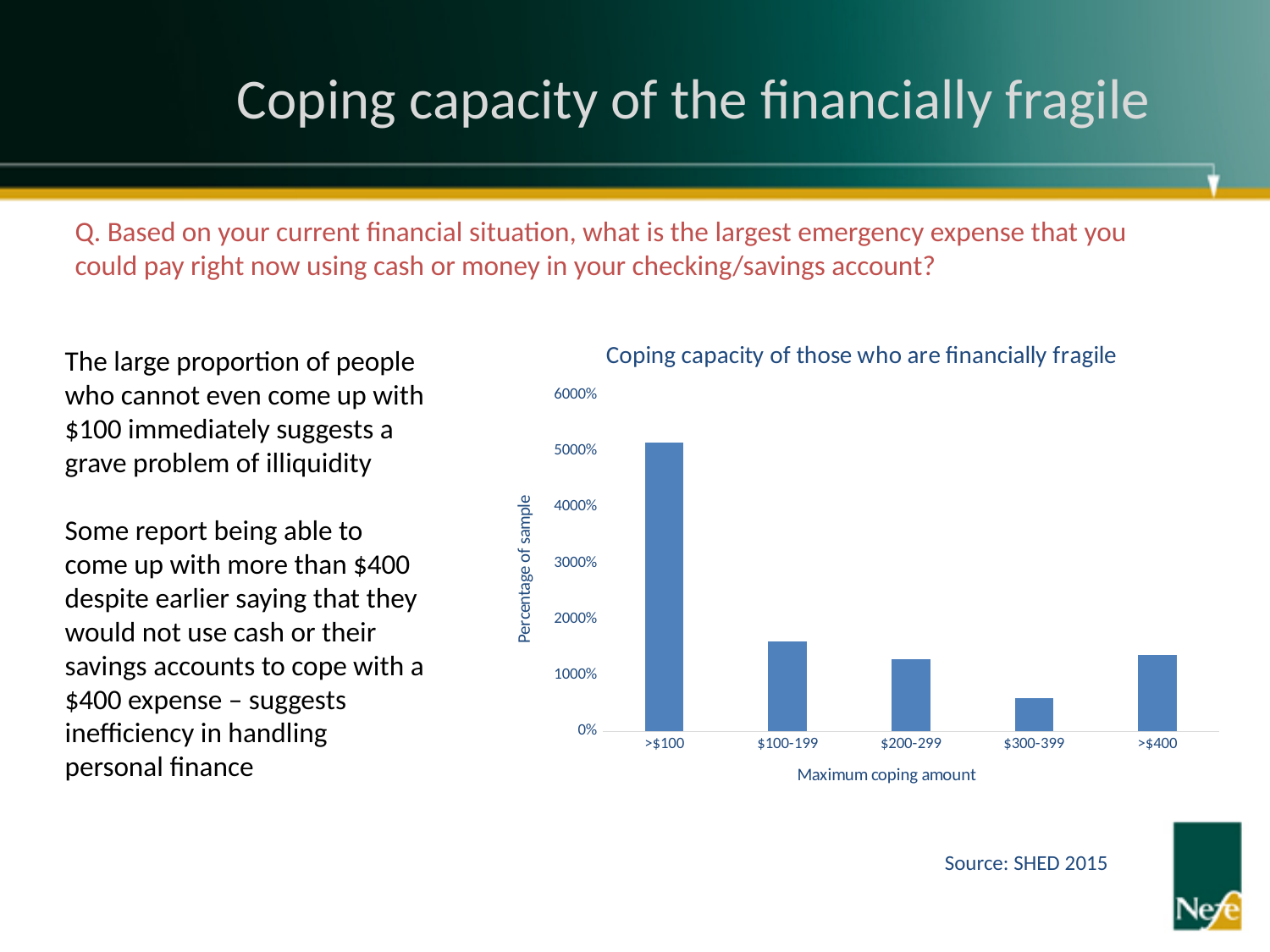
Is the value for $100-199 greater or less than 1000%? greater How many categories are shown on the x axis of the chart? 5 Is the value for >$400 greater or less than 2000%? less Which is larger, the value for >$100 or the value for $100-199? >$100 Which category has the lowest bar in the chart? $300-399 Is the value for >$100 greater or less than 4000%? greater What is the title of the chart? Coping capacity of those who are financially fragile Which is larger, the value for $100-199 or the value for $300-399? $100-199 Which category has the highest bar in the chart? >$100 What kind of chart is shown on the slide? bar chart What is the label of the chart's x axis? Maximum coping amount